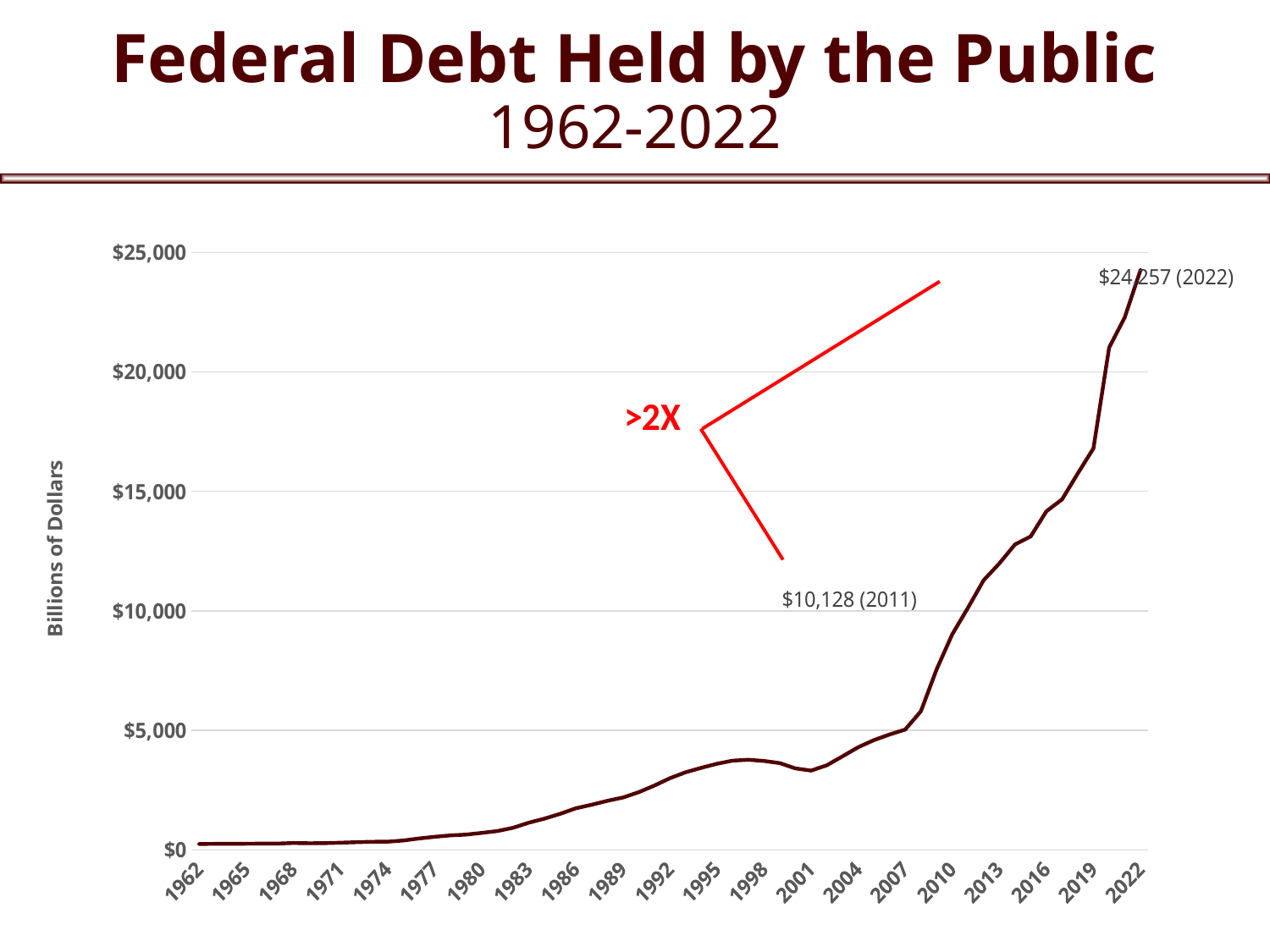
What text does the red annotation between the two labelled points show? >2X What is the value of federal debt held by the public in 2022? $24,257 Is the value for 2013 greater or less than $10,000? greater What kind of chart is shown on the slide? line chart What is the difference between the 2022 value and the 2011 value? $14,129 Which year has the highest federal debt held by the public? 2022 What is the value of federal debt held by the public in 2011? $10,128 Is the value for 2019 greater or less than $15,000? greater Overall, do the values rise or fall from 1962 to 2022? rise What is the title of the y axis? Billions of Dollars Which is larger, the value for 2011 or the value for 2022? 2022 Is the value for 2004 greater or less than $5,000? less